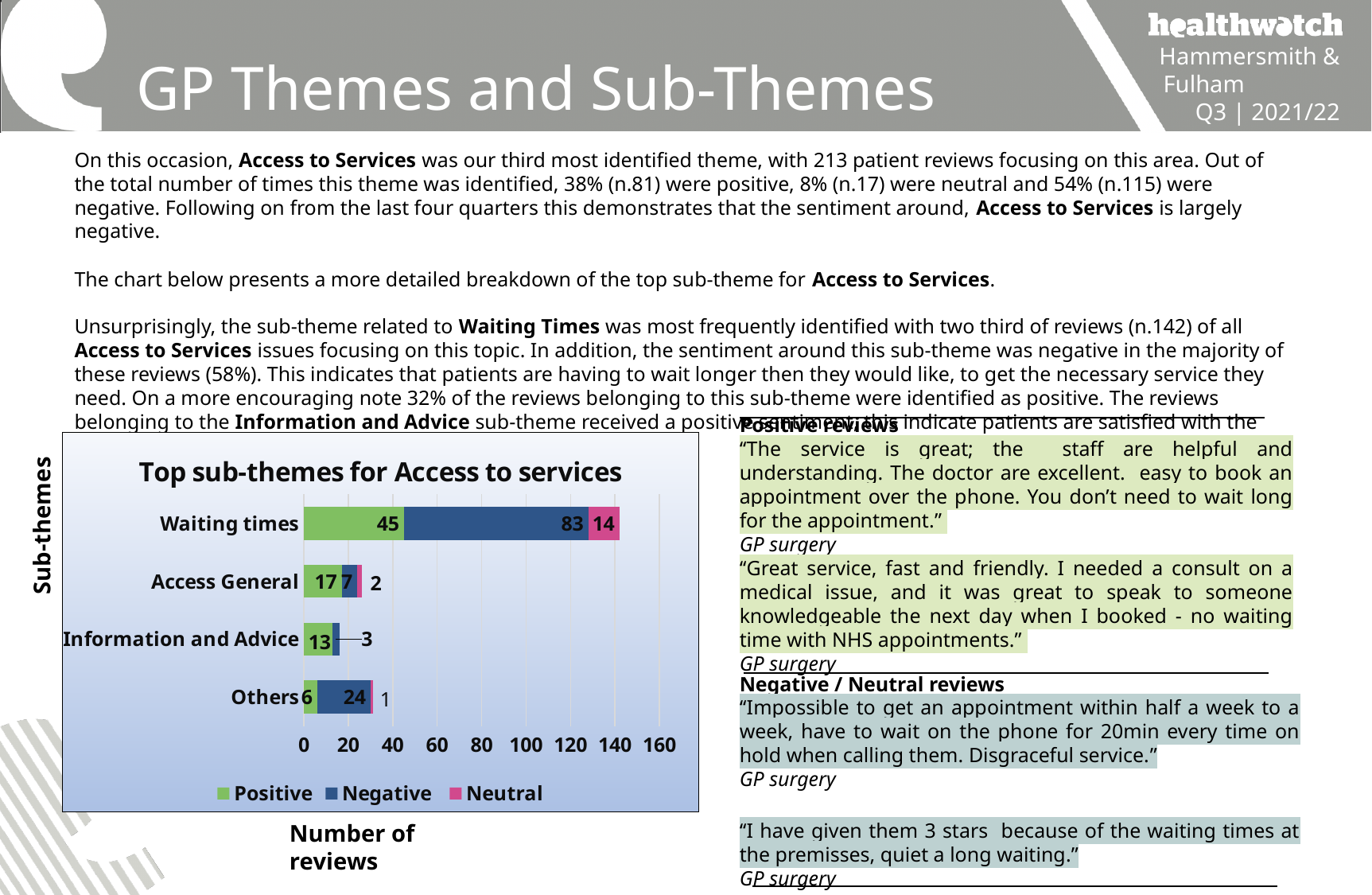
In the 'Top sub-themes for Access to services' chart, is the Positive value for Access General larger or the Negative value for Others? Negative value for Others What is the Positive value for Access General in the 'Top sub-themes for Access to services' chart? 17 What kind of chart is 'Top sub-themes for Access to services'? bar chart What is the Negative value for Waiting times in the 'Top sub-themes for Access to services' chart? 83 Which sub-theme has the highest Negative value in the 'Top sub-themes for Access to services' chart? Waiting times What is the Negative value for Others in the 'Top sub-themes for Access to services' chart? 24 What is the difference between the Negative and Positive values for Waiting times in the 'Top sub-themes for Access to services' chart? 38 What is the Neutral value for Waiting times in the 'Top sub-themes for Access to services' chart? 14 How many sub-theme categories are shown in the 'Top sub-themes for Access to services' chart? 4 How many series does the legend of the 'Top sub-themes for Access to services' chart list? 3 Which sub-theme has the lowest Positive value in the 'Top sub-themes for Access to services' chart? Others What is the total of the stacked bar for Waiting times in the 'Top sub-themes for Access to services' chart? 142